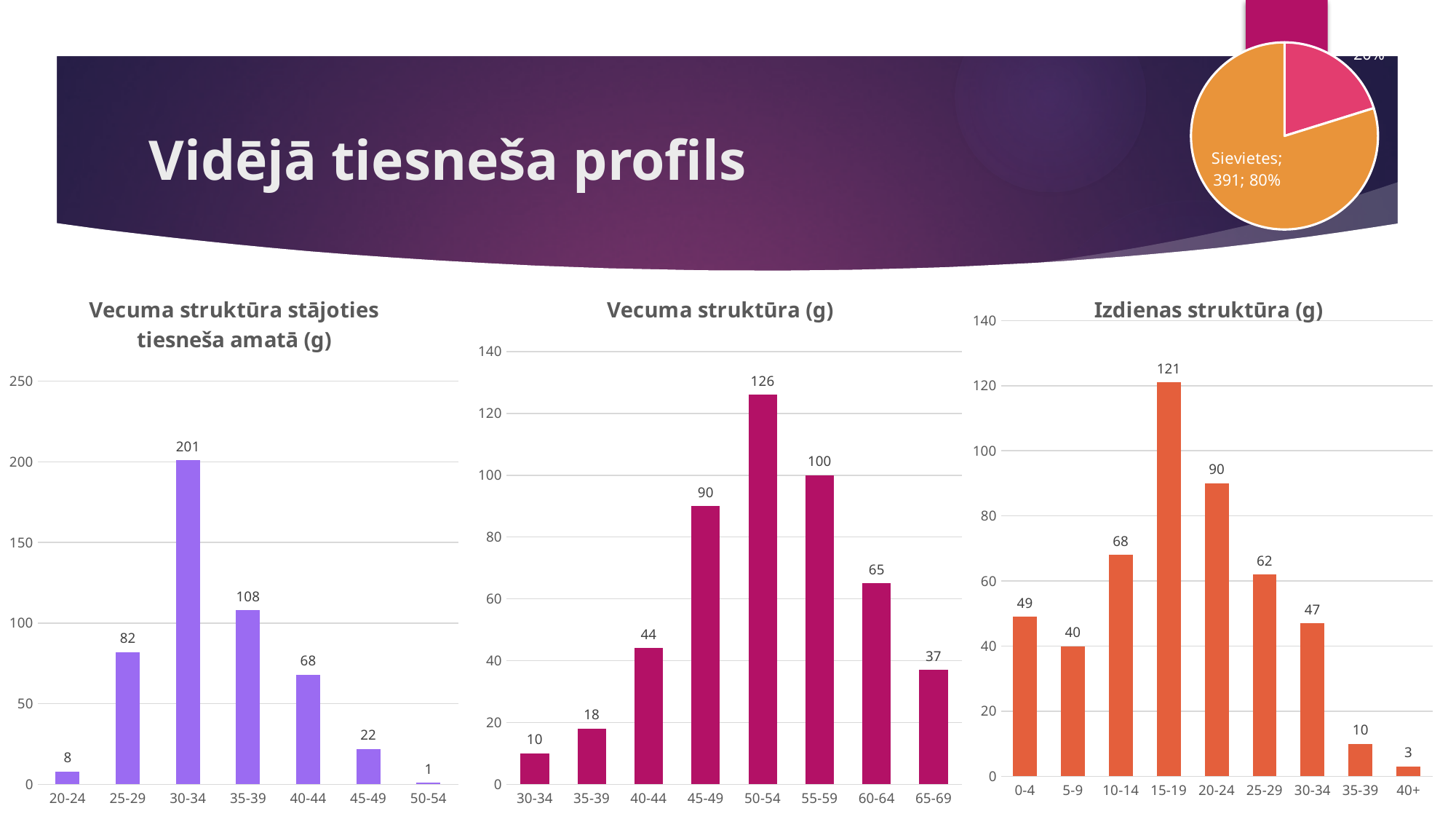
In the chart 'Izdienas struktūra (g)', how many categories are shown on the x axis? 9 In the chart 'Vecuma struktūra stājoties tiesneša amatā (g)', what is the difference between the values for 35-39 and 40-44? 40 In the chart 'Vecuma struktūra (g)', which category has the highest value? 50-54 In the chart 'Vecuma struktūra stājoties tiesneša amatā (g)', how many categories are shown on the x axis? 7 In the chart 'Vecuma struktūra (g)', what is the value for the 65-69 category? 37 In the pie chart at the top right, what share does the 'Sievietes' slice represent? 80% In the chart 'Vecuma struktūra stājoties tiesneša amatā (g)', what is the value for the 30-34 category? 201 What kind of chart is 'Izdienas struktūra (g)'? bar chart In the chart 'Vecuma struktūra (g)', what is the total of the values for 30-34 and 35-39? 28 In the chart 'Izdienas struktūra (g)', what is the value for the 15-19 category? 121 In the chart 'Vecuma struktūra stājoties tiesneša amatā (g)', which category has the lowest value? 50-54 In the chart 'Vecuma struktūra (g)', which is larger, the value for 45-49 or the value for 55-59? 55-59